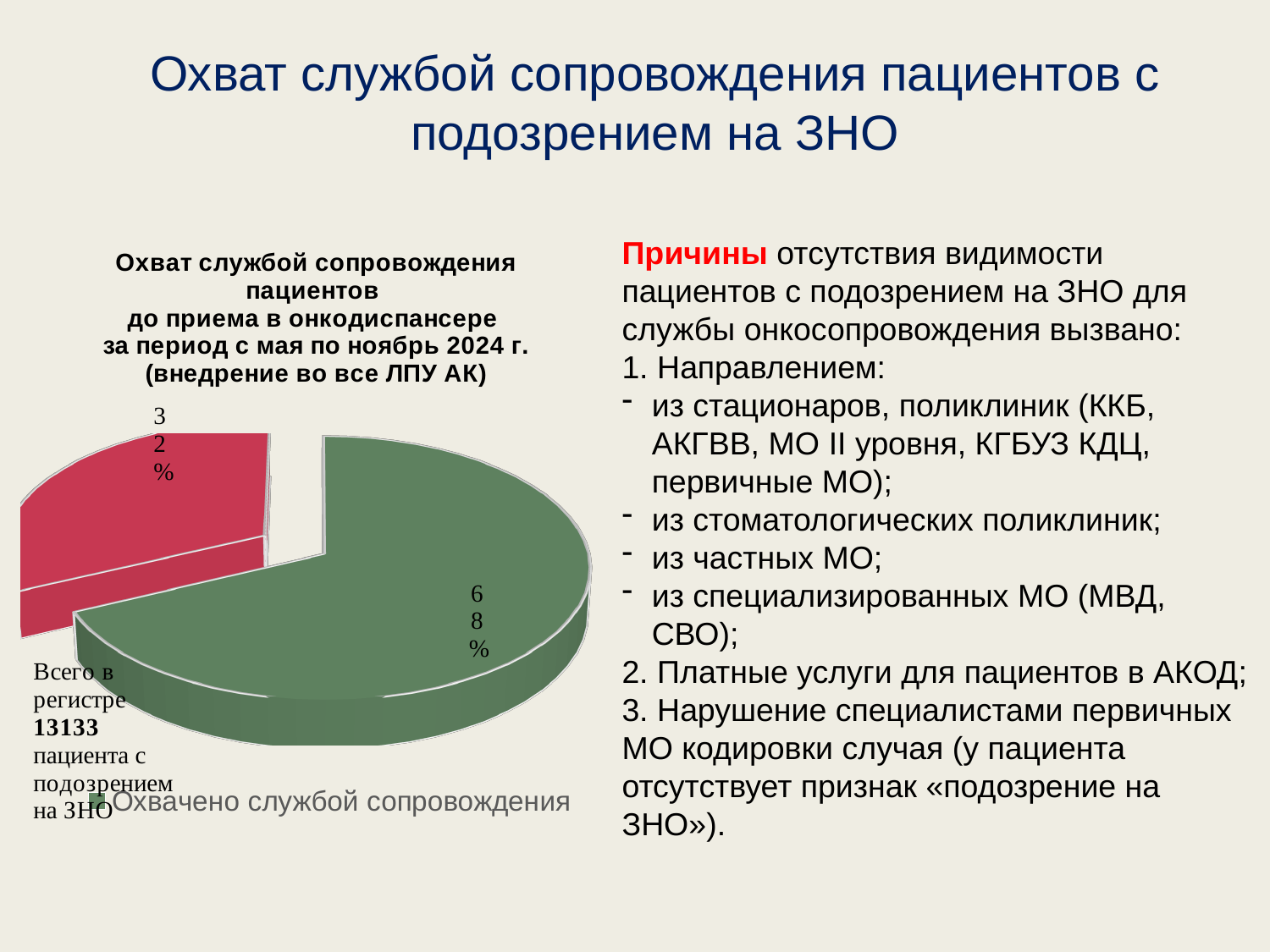
What share of the pie does the red slice represent? 32% What colour is the slice for "Охвачено службой сопровождения"? Green How many entries does the chart legend list? 1 Which slice of the pie is the largest? Охвачено службой сопровождения (68%) Which slice of the pie is the smallest? The red slice (32%) What share of the pie does the slice labelled "Охвачено службой сопровождения" (green) represent? 68% What kind of chart is shown on the slide? Pie chart By how many percentage points does the green slice exceed the red slice? 36 percentage points Is the share of the green slice greater or less than 50%? greater According to the chart title, what period does the chart cover? с мая по ноябрь 2024 г. Which slice is larger, the green one or the red one? The green one (68%) How many slices does the pie chart have? 2